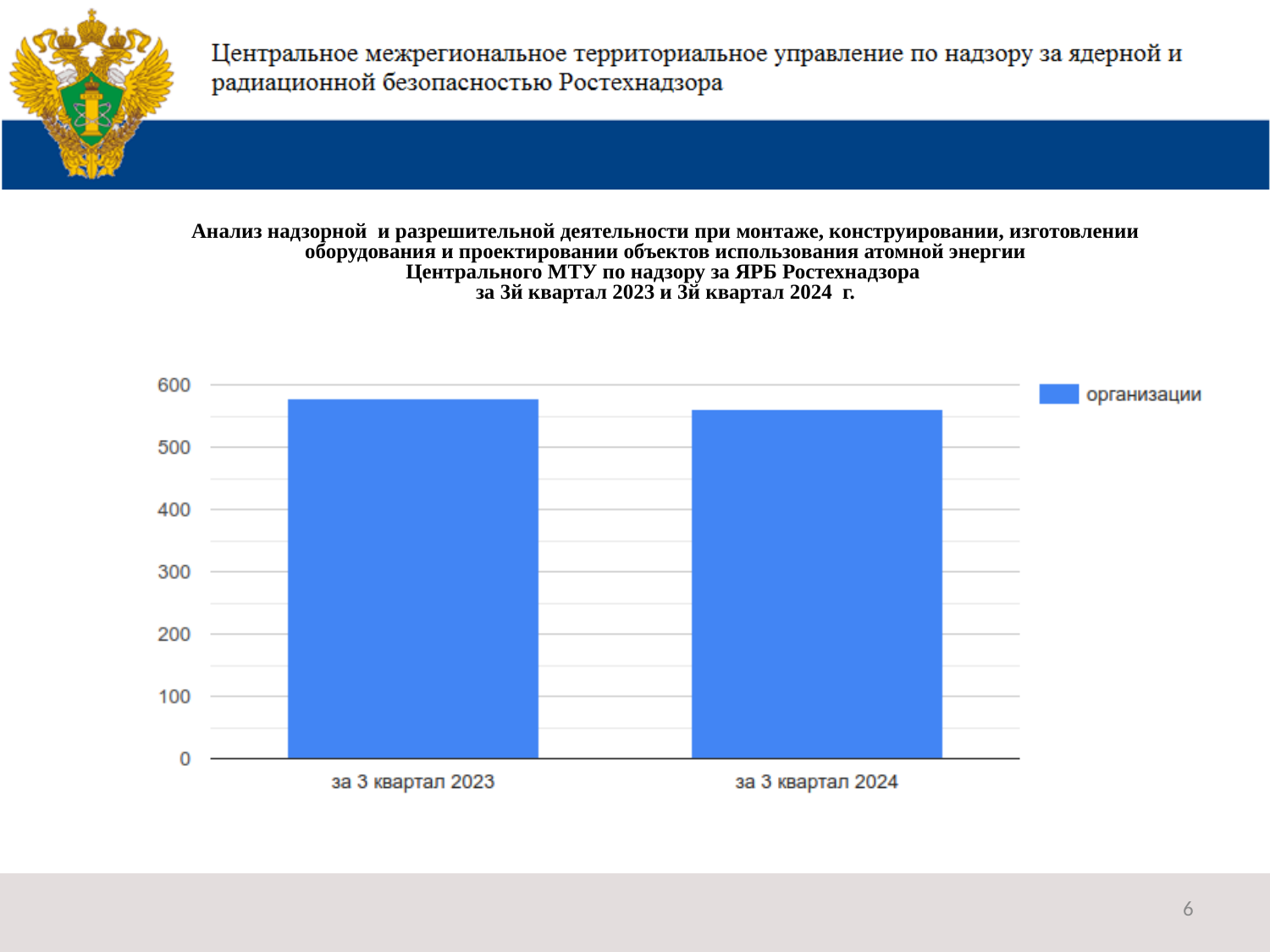
Which category has the higher value: "за 3 квартал 2023" or "за 3 квартал 2024"? за 3 квартал 2023 How many categories are shown on the x axis of the chart? 2 Is the value for "за 3 квартал 2023" greater or less than 500? greater Do the values rise or fall from "за 3 квартал 2023" to "за 3 квартал 2024"? fall Is the value for "за 3 квартал 2024" greater or less than 600? less What type of chart is shown on the slide? bar chart What is the name of the series shown in the chart legend? организации Which category has the lowest value in the chart? за 3 квартал 2024 Is the value for "за 3 квартал 2023" greater or less than 600? less What is the highest tick value shown on the y axis of the chart? 600 How many series does the chart legend list? 1